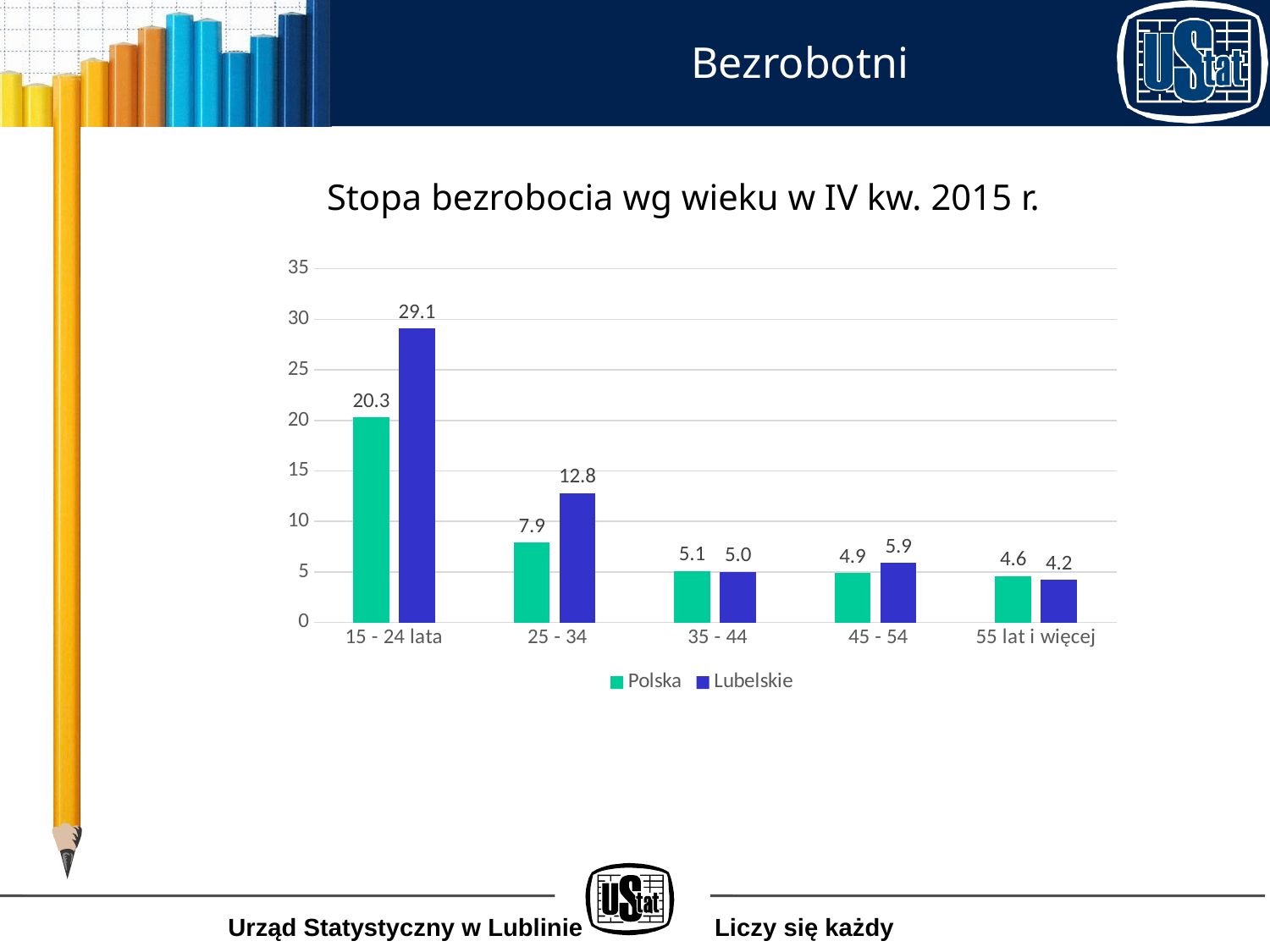
Which age group has the highest value for Polska? 15 - 24 lata How many series does the legend list? 2 In the 25 - 34 age group, which series has the larger value, Polska or Lubelskie? Lubelskie What is the difference between the Lubelskie and Polska values in the 15 - 24 lata age group? 8.8 Is the value for Lubelskie in the 25 - 34 age group greater or less than 10? greater What is the value for Polska in the 25 - 34 age group? 7.9 What is the value for Lubelskie in the 55 lat i więcej age group? 4.2 What kind of chart is shown on the slide? bar chart Which age group has the lowest value for Lubelskie? 55 lat i więcej What is the title of the chart? Stopa bezrobocia wg wieku w IV kw. 2015 r. What is the value for Lubelskie in the 15 - 24 lata age group? 29.1 How many age groups are shown on the x axis? 5